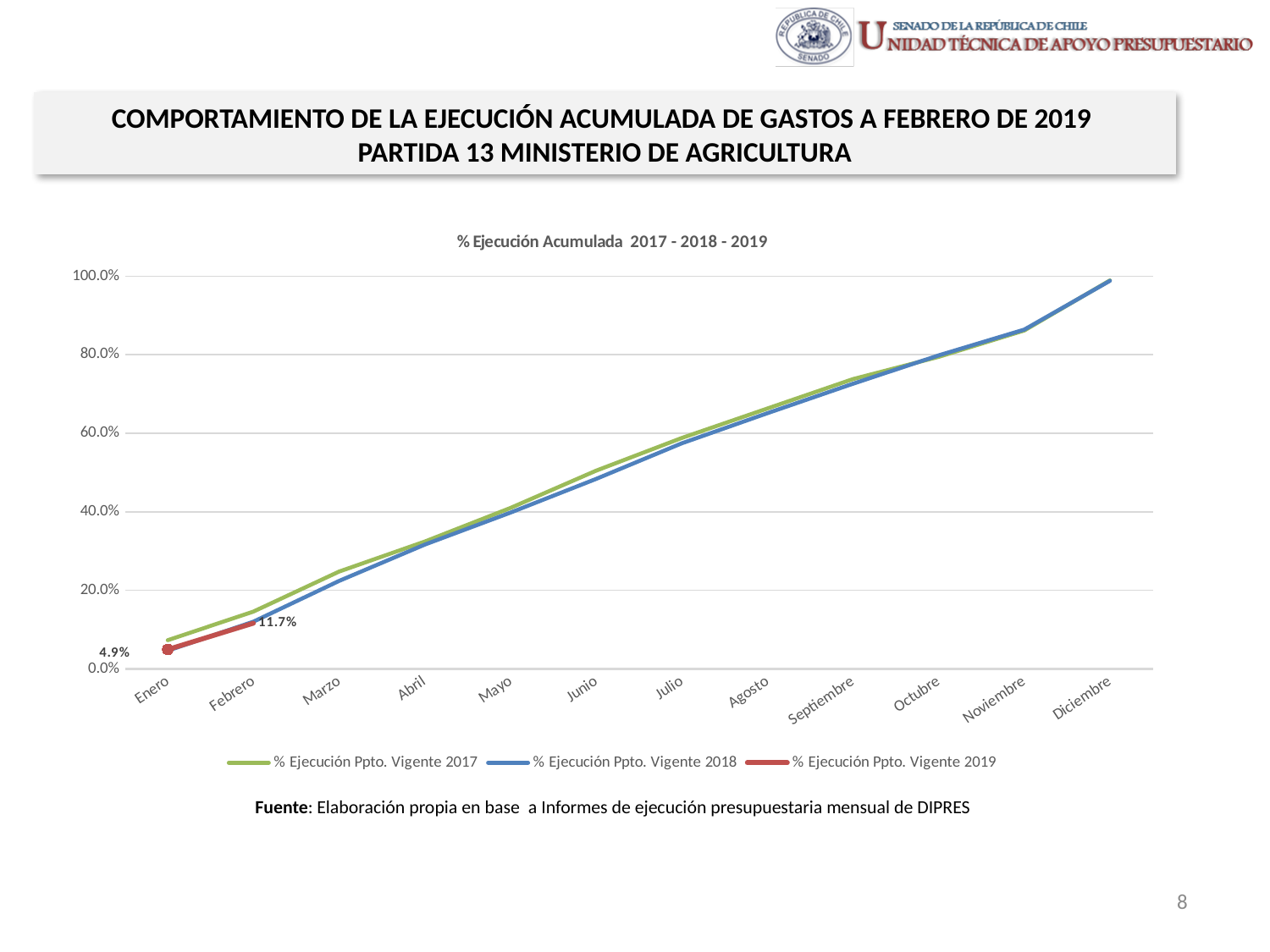
What is the value of % Ejecución Ppto. Vigente 2019 for Febrero? 11.7% By how many percentage points did % Ejecución Ppto. Vigente 2019 increase from Enero to Febrero? 6.8 percentage points In which month does % Ejecución Ppto. Vigente 2018 reach its highest value? Diciembre Is the value of % Ejecución Ppto. Vigente 2018 for Junio greater or less than 60.0%? less Which is larger for the 2019 series: the value for Enero or the value for Febrero? Febrero What kind of chart is shown on the slide? line chart Do the values of % Ejecución Ppto. Vigente 2018 rise or fall from Enero to Diciembre? rise Is the value of % Ejecución Ppto. Vigente 2018 for Diciembre greater or less than 80.0%? greater How many series does the chart legend list? 3 How many months are shown along the x axis of the chart? 12 What is the value of % Ejecución Ppto. Vigente 2019 for Enero? 4.9% What is the title of the chart? % Ejecución Acumulada 2017 - 2018 - 2019